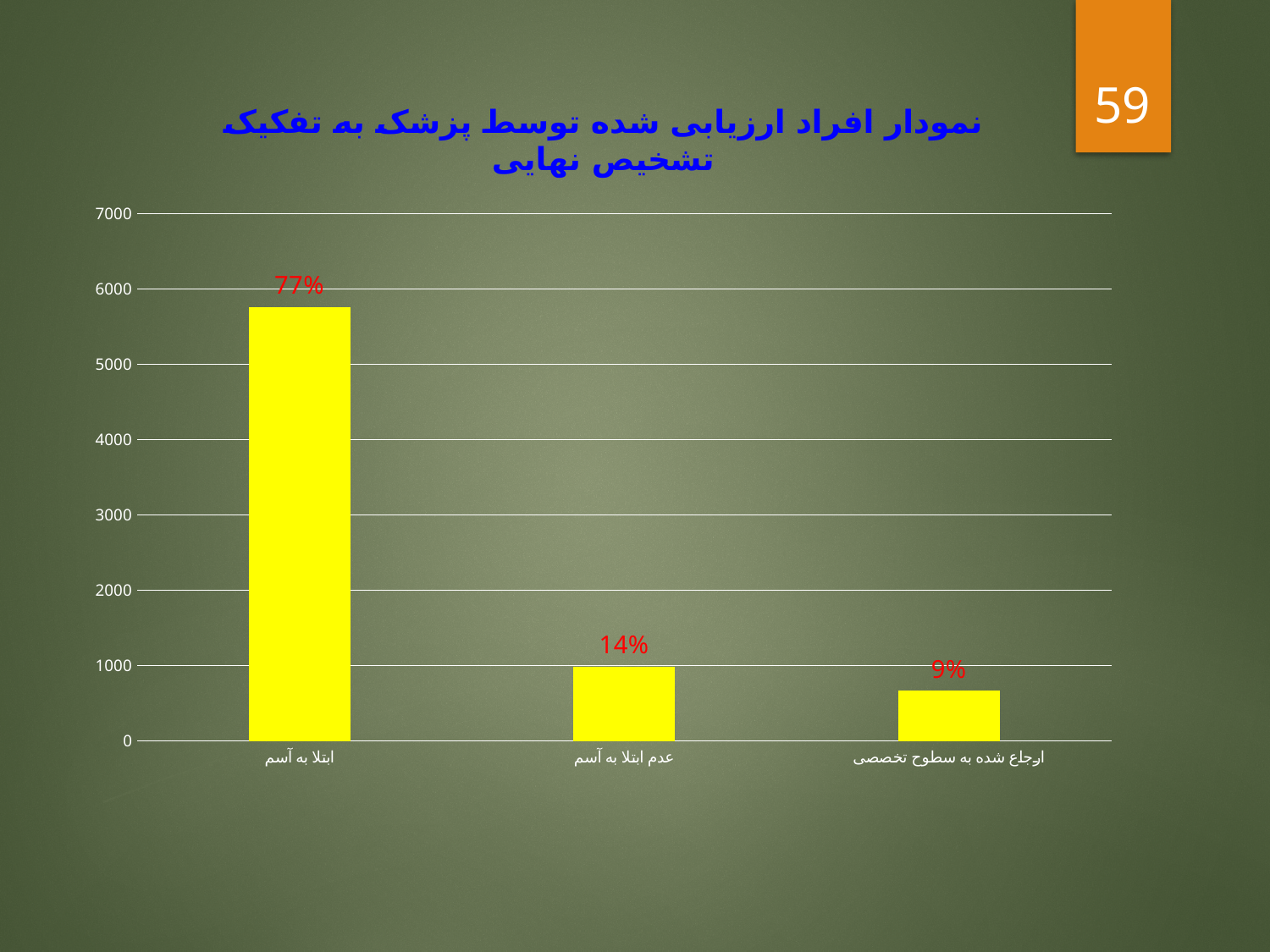
Do the bar values rise or fall from left to right along the x axis? fall Which category has the highest bar? ابتلا به آسم Is the value for ارجاع شده به سطوح تخصصی greater or less than 1000? less What colour are the bars in the chart? yellow What data label is shown on the bar for ابتلا به آسم? 77% What kind of chart is shown on the slide? bar chart Is the value for ابتلا به آسم greater or less than 5000? greater What data label is shown on the bar for ارجاع شده به سطوح تخصصی? 9% What data label is shown on the bar for عدم ابتلا به آسم? 14% How many categories are shown on the x axis? 3 Which category has the lowest bar? ارجاع شده به سطوح تخصصی Which is larger, the bar for عدم ابتلا به آسم or the bar for ارجاع شده به سطوح تخصصی? عدم ابتلا به آسم